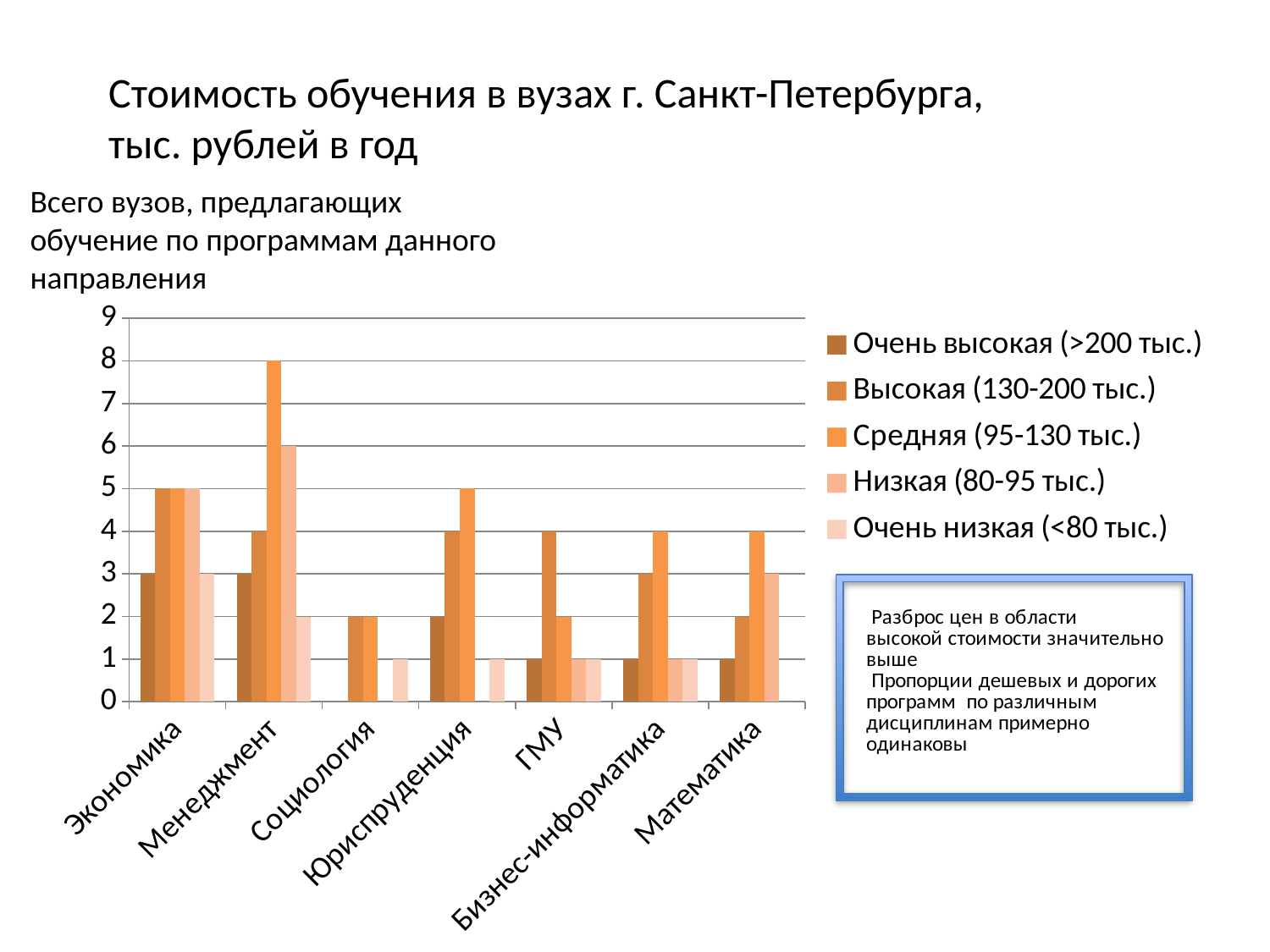
What is the value for Высокая (130-200 тыс.) in Экономика? 5 How many categories (directions of study) are shown on the x axis? 7 Which category has the lowest value for Высокая (130-200 тыс.)? Социология and Математика (tied at 2) Which is larger: the Высокая (130-200 тыс.) value for ГМУ or for Математика? ГМУ Which category has the highest value for Средняя (95-130 тыс.)? Менеджмент Which legend entry corresponds to the lightest-coloured bars? Очень низкая (<80 тыс.) What is the value for Средняя (95-130 тыс.) in Юриспруденция? 5 What is the value for Низкая (80-95 тыс.) in Менеджмент? 6 What is the value for Средняя (95-130 тыс.) in Менеджмент? 8 What kind of chart is shown on the slide? bar chart How many series does the legend list? 5 What is the difference between the Средняя (95-130 тыс.) value for Менеджмент and for Экономика? 3